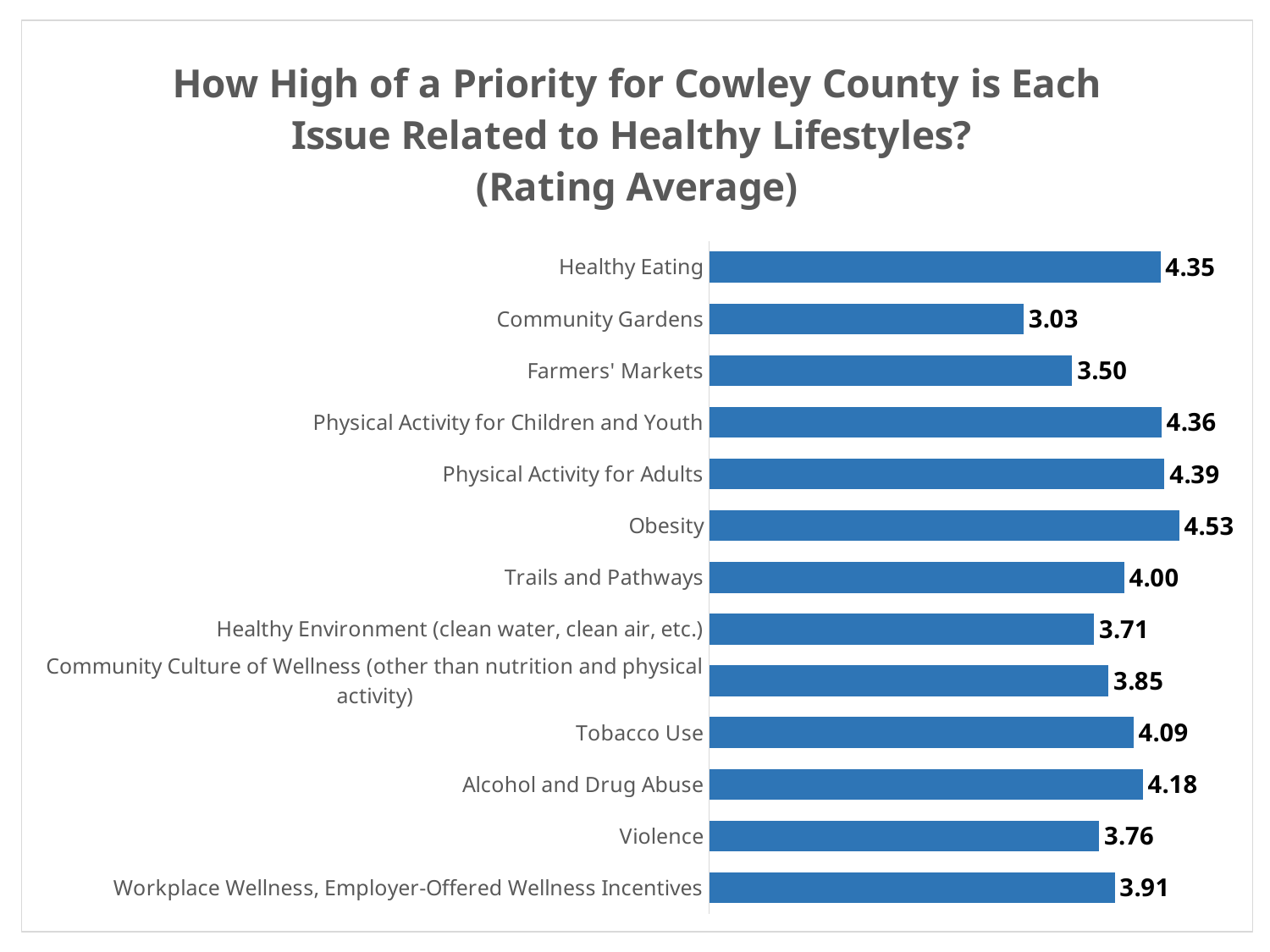
What is the rating average for Trails and Pathways? 4.00 What is the difference between the rating averages for Obesity and Community Gardens? 1.50 What is the rating average for Workplace Wellness, Employer-Offered Wellness Incentives? 3.91 What is the rating average for Obesity? 4.53 How many issues are shown in the chart? 13 What kind of chart is shown on the slide? Bar chart What is the rating average for Community Gardens? 3.03 Which issue has the highest rating average? Obesity Which has a higher rating average, Farmers' Markets or Violence? Violence What is the difference between the rating averages for Alcohol and Drug Abuse and Tobacco Use? 0.09 What is the title of the chart? How High of a Priority for Cowley County is Each Issue Related to Healthy Lifestyles? (Rating Average) Which issue has the lowest rating average? Community Gardens